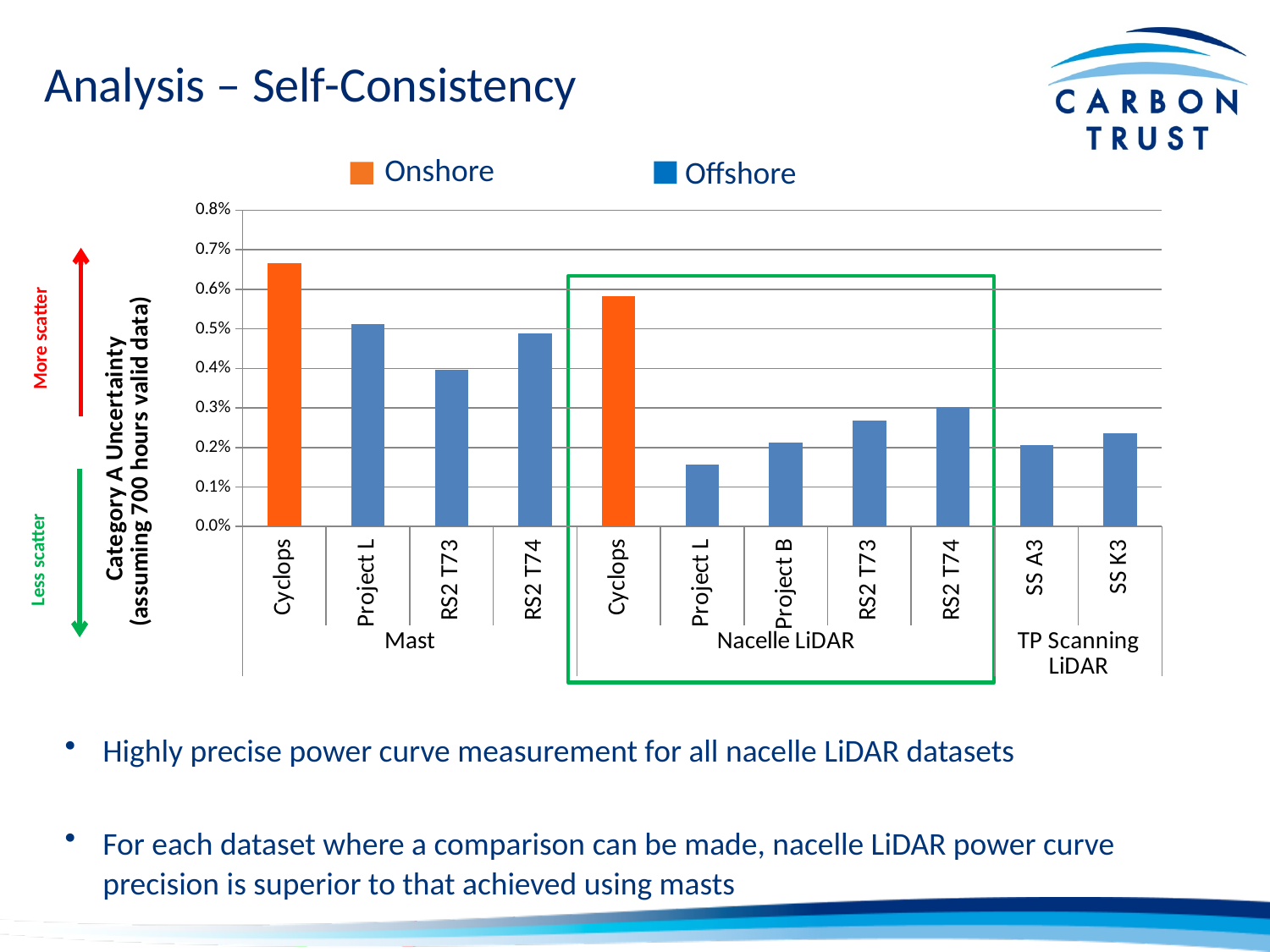
Which is larger: the Project L value in the Mast group or the Project L value in the Nacelle LiDAR group? Mast Is the value for Project L in the Nacelle LiDAR group greater or less than 0.2%? less Is the value for Cyclops in the Mast group greater or less than 0.6%? greater Which bar has the lowest Category A Uncertainty? Project L (Nacelle LiDAR) Which is larger: the Cyclops value in the Mast group or the Cyclops value in the Nacelle LiDAR group? Mast What kind of chart is shown on the slide? bar chart How many bars are plotted in the chart? 11 Is the value for Cyclops in the Nacelle LiDAR group greater or less than 0.5%? greater How many entries does the legend list? 2 Which legend entry is shown in orange? Onshore Which bar has the highest Category A Uncertainty? Cyclops (Mast)